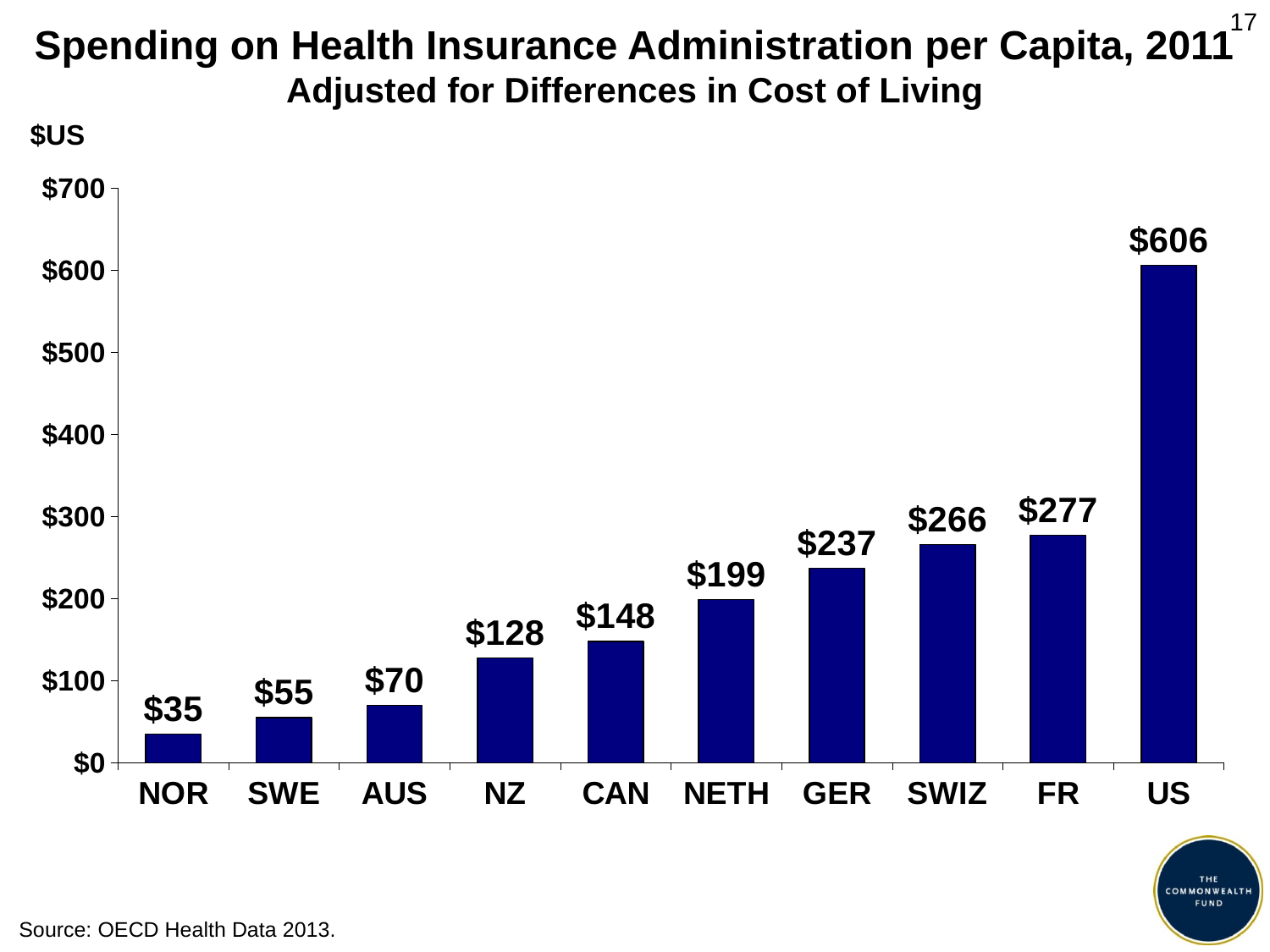
Which country has the highest spending on health insurance administration per capita? US What is the subtitle of the chart? Adjusted for Differences in Cost of Living Is the value for Australia (AUS) greater or less than $100? less What is the difference between the values for the US and France (FR)? $329 What is the spending on health insurance administration per capita for Canada (CAN)? $148 What is the difference between the values for Germany (GER) and Sweden (SWE)? $182 Which has a higher value, Switzerland (SWIZ) or New Zealand (NZ)? SWIZ Which country has the lowest spending on health insurance administration per capita? NOR How many countries are shown in the chart? 10 What is the value shown for the Netherlands (NETH)? $199 Do the values rise or fall moving from left to right along the x axis? Rise What kind of chart is shown on the slide? Bar chart